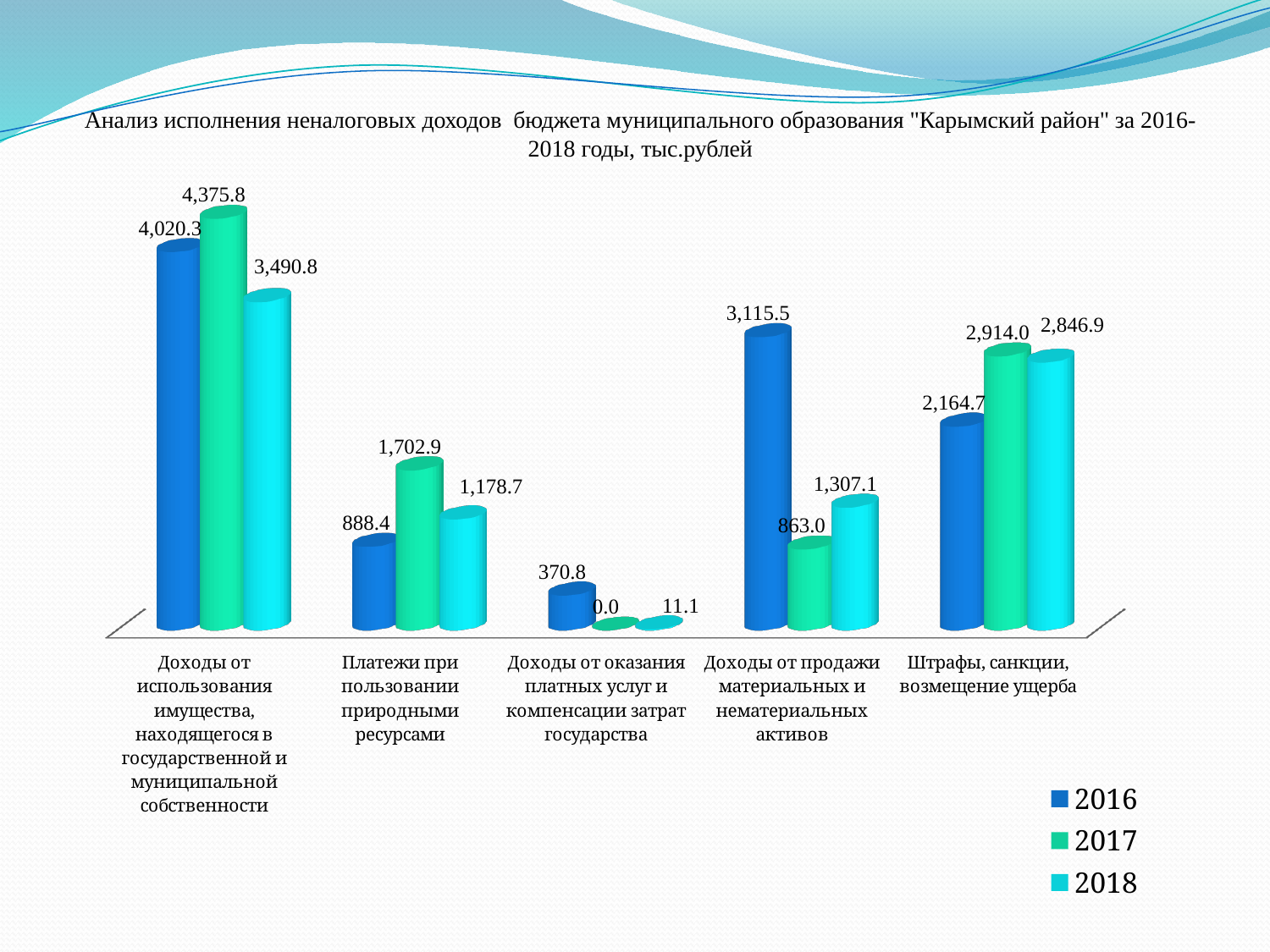
For "Штрафы, санкции, возмещение ущерба", which is larger: the 2016 value or the 2017 value? 2017 How many categories are shown on the x axis? 5 What type of chart is shown on the slide? Bar chart What is the difference between the 2016 and 2017 values for "Доходы от продажи материальных и нематериальных активов"? 2,252.5 What is the 2017 value for "Доходы от оказания платных услуг и компенсации затрат государства"? 0.0 Which category has the highest 2016 value? Доходы от использования имущества, находящегося в государственной и муниципальной собственности What unit of measurement is stated in the chart title? тыс.рублей What is the 2016 value for "Доходы от продажи материальных и нематериальных активов"? 3,115.5 What is the 2018 value for "Платежи при пользовании природными ресурсами"? 1,178.7 What is the 2017 value for "Доходы от использования имущества, находящегося в государственной и муниципальной собственности"? 4,375.8 Which category has the lowest 2018 value? Доходы от оказания платных услуг и компенсации затрат государства How many series does the legend list? 3